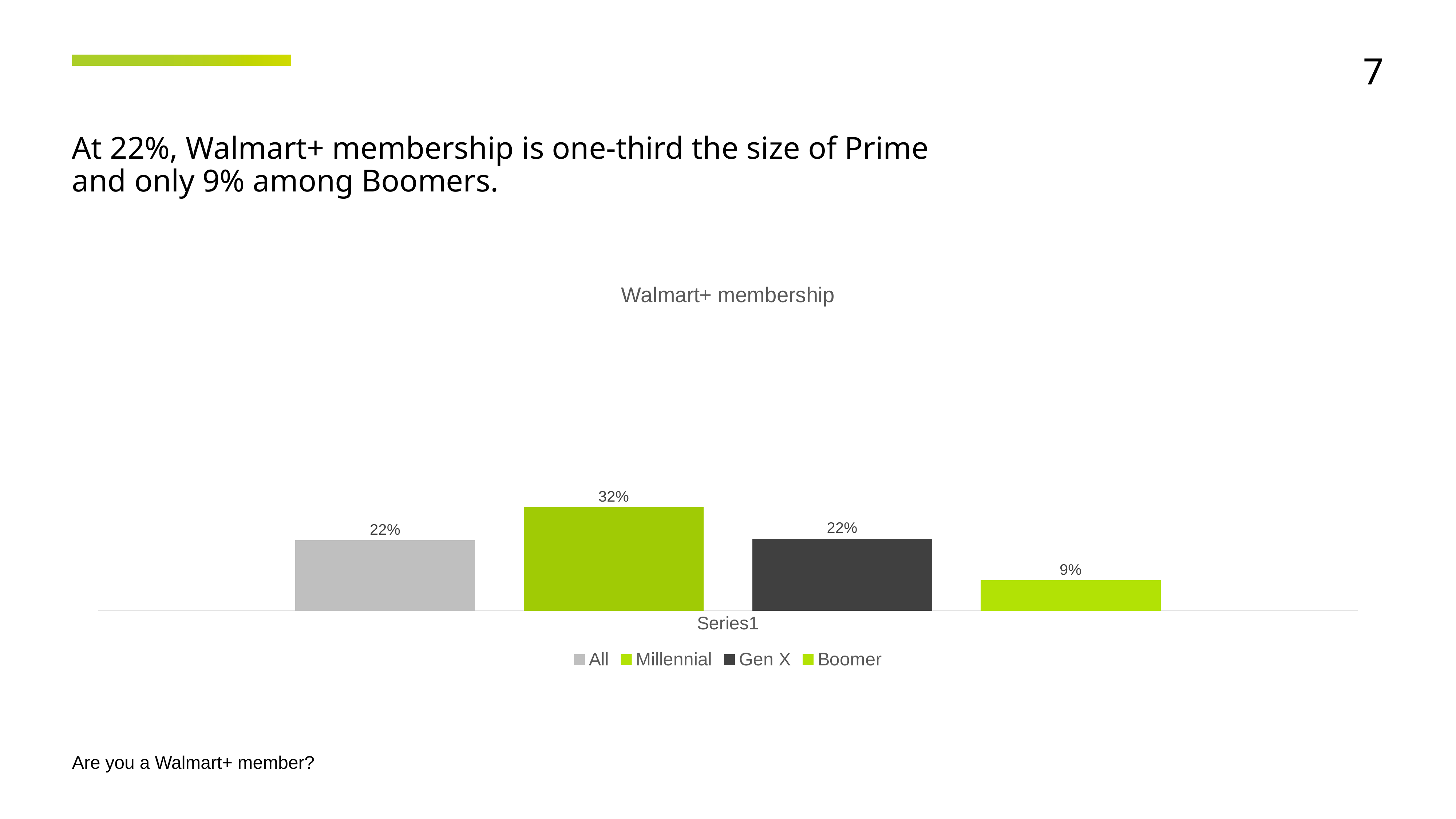
What is the difference between the Millennial and Gen X values in the Walmart+ membership chart? 10% Which group has the lowest Walmart+ membership in the chart? Boomer What is the value for Gen X in the Walmart+ membership chart? 22% What is the title of the chart on the slide? Walmart+ membership Which group has the highest Walmart+ membership in the chart? Millennial How many series does the legend of the Walmart+ membership chart list? 4 Which is larger in the Walmart+ membership chart, the value for Millennial or the value for Boomer? Millennial What is the difference between the Millennial and Boomer values in the Walmart+ membership chart? 23% What is the value for Boomer in the Walmart+ membership chart? 9% What kind of chart is the Walmart+ membership chart? bar chart What is the value for All in the Walmart+ membership chart? 22% What is the value for Millennial in the Walmart+ membership chart? 32%